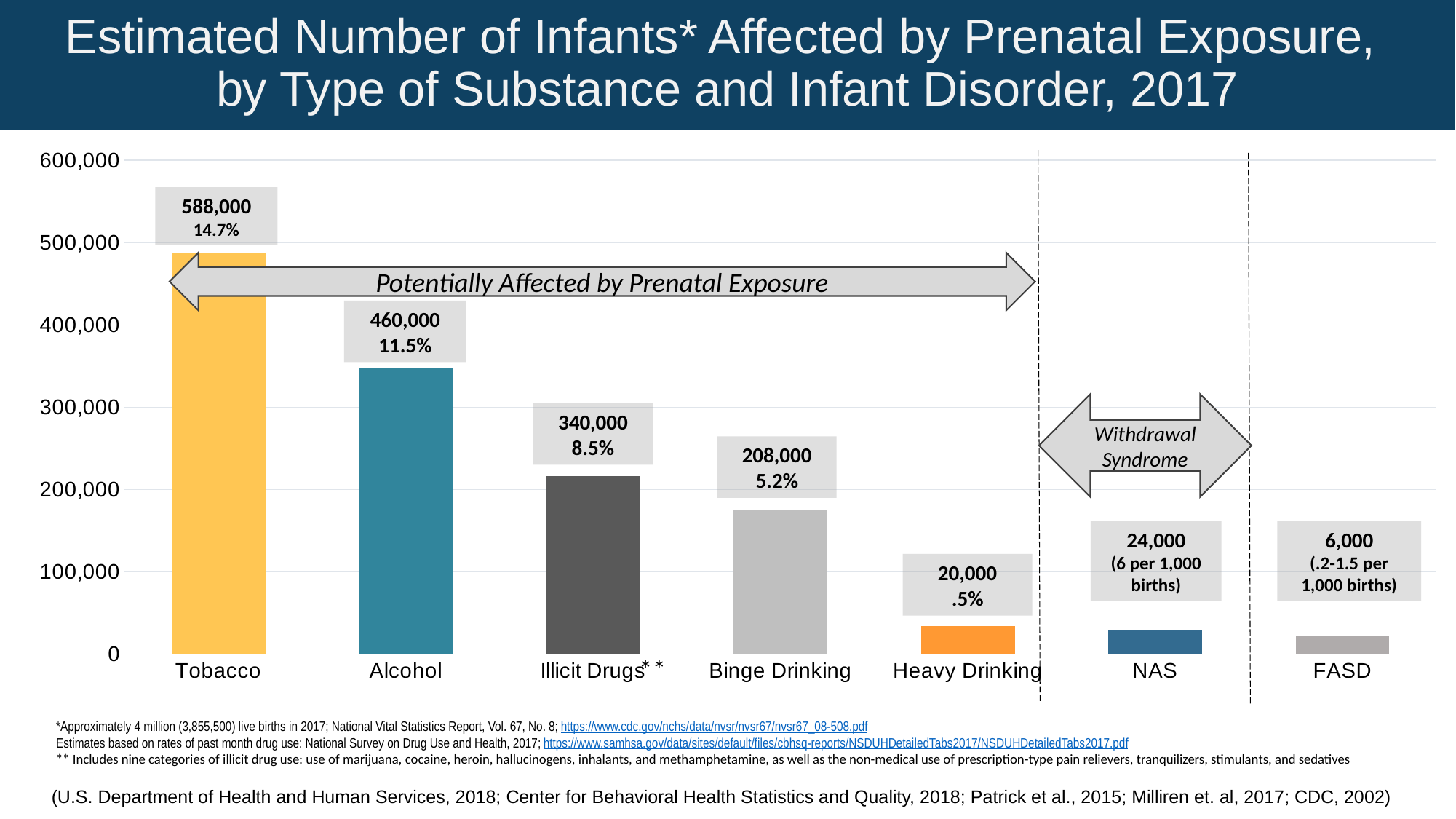
What label is written on the wide horizontal arrow spanning the first five bars? Potentially Affected by Prenatal Exposure What is the estimated number of infants affected by prenatal exposure to Tobacco? 588,000 What is the difference between the estimated numbers for Tobacco and Alcohol? 128,000 Is the value for Illicit Drugs greater or less than 100,000? greater What percentage is shown for Alcohol? 11.5% What is the estimated number of infants for Binge Drinking? 208,000 How many categories are shown on the x axis of the chart? 7 What is the estimated number of infants with NAS? 24,000 Which category has the highest estimated number of infants? Tobacco What kind of chart is shown on the slide? Bar chart Which category has the lowest estimated number of infants? FASD